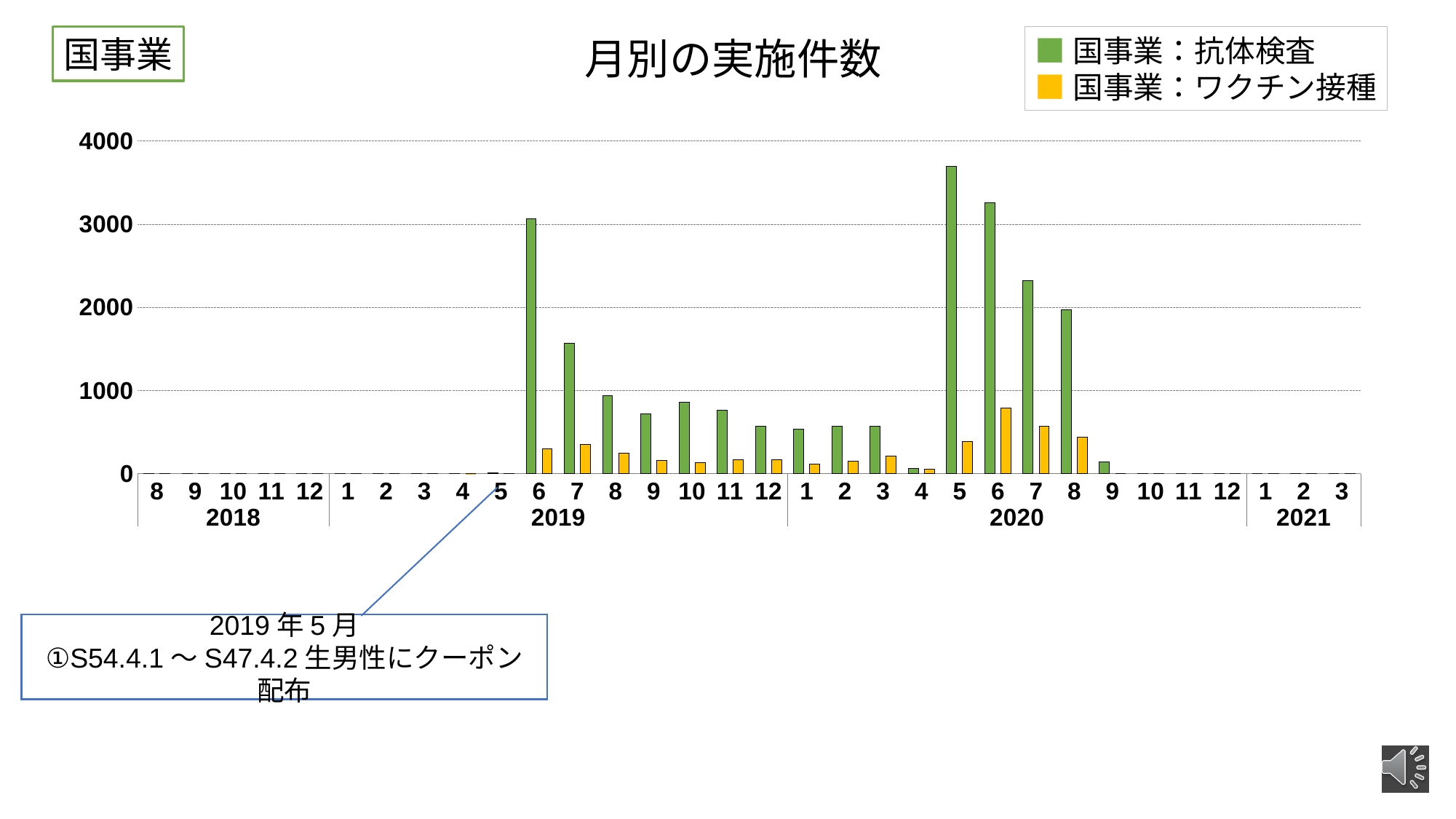
Do the 国事業：抗体検査 values rise or fall from 2020年5月 to 2020年9月? fall Is the 国事業：抗体検査 value for 2019年7月 greater or less than 1000? greater Is the 国事業：抗体検査 value for 2020年7月 greater or less than 2000? greater In which month is the 国事業：ワクチン接種 value highest? 2020年6月 Which series is shown in yellow according to the legend? 国事業：ワクチン接種 What kind of chart is shown on the slide? bar chart Is the 国事業：抗体検査 value for 2020年5月 greater or less than 3000? greater Which is larger, the 国事業：抗体検査 value for 2020年5月 or for 2019年6月? 2020年5月 In which month is the 国事業：抗体検査 value highest? 2020年5月 How many series does the legend list? 2 What is the title of the chart? 月別の実施件数